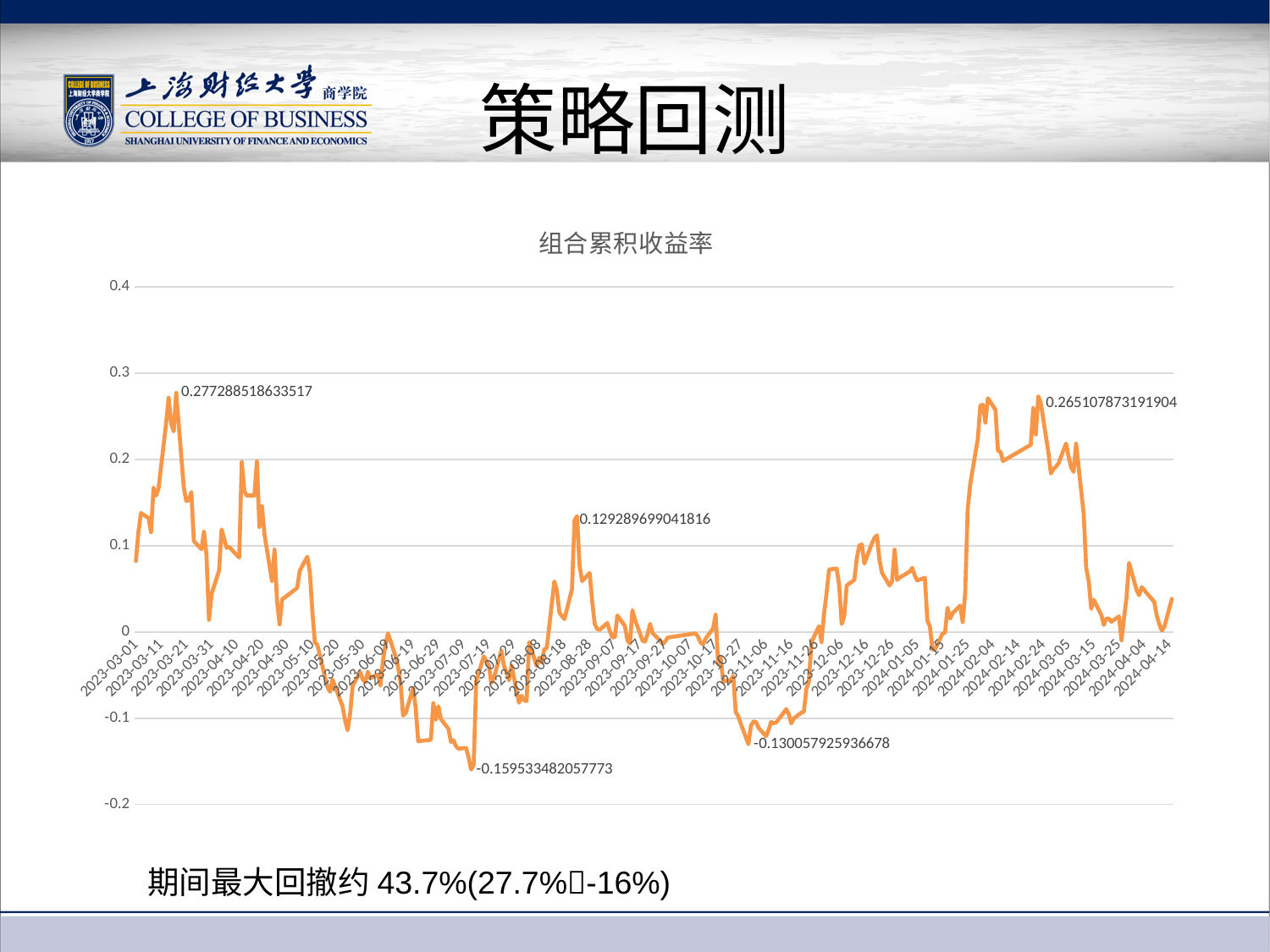
What is the labeled value of the local peak near 2023-08-18? 0.129289699041816 Is the value of the line at 2024-02-04 greater or less than 0.2? greater What is the title of the chart? 组合累积收益率 Which labeled peak is higher: the one near 2023-03-21 or the one near 2024-02-24? the one near 2023-03-21 What kind of chart is shown on the slide? line chart What is the highest labeled value on the line? 0.277288518633517 What is the labeled value of the peak near 2024-02-24? 0.265107873191904 Is the value of the line at 2023-06-29 greater or less than 0? less What is the labeled value of the trough near 2023-11-06? -0.130057925936678 Which labeled trough is lower: the one near 2023-07-19 or the one near 2023-11-06? the one near 2023-07-19 What is the difference between the labeled peak 0.277288518633517 and the labeled trough -0.159533482057773? 0.43682200069129 What is the lowest labeled value on the line? -0.159533482057773